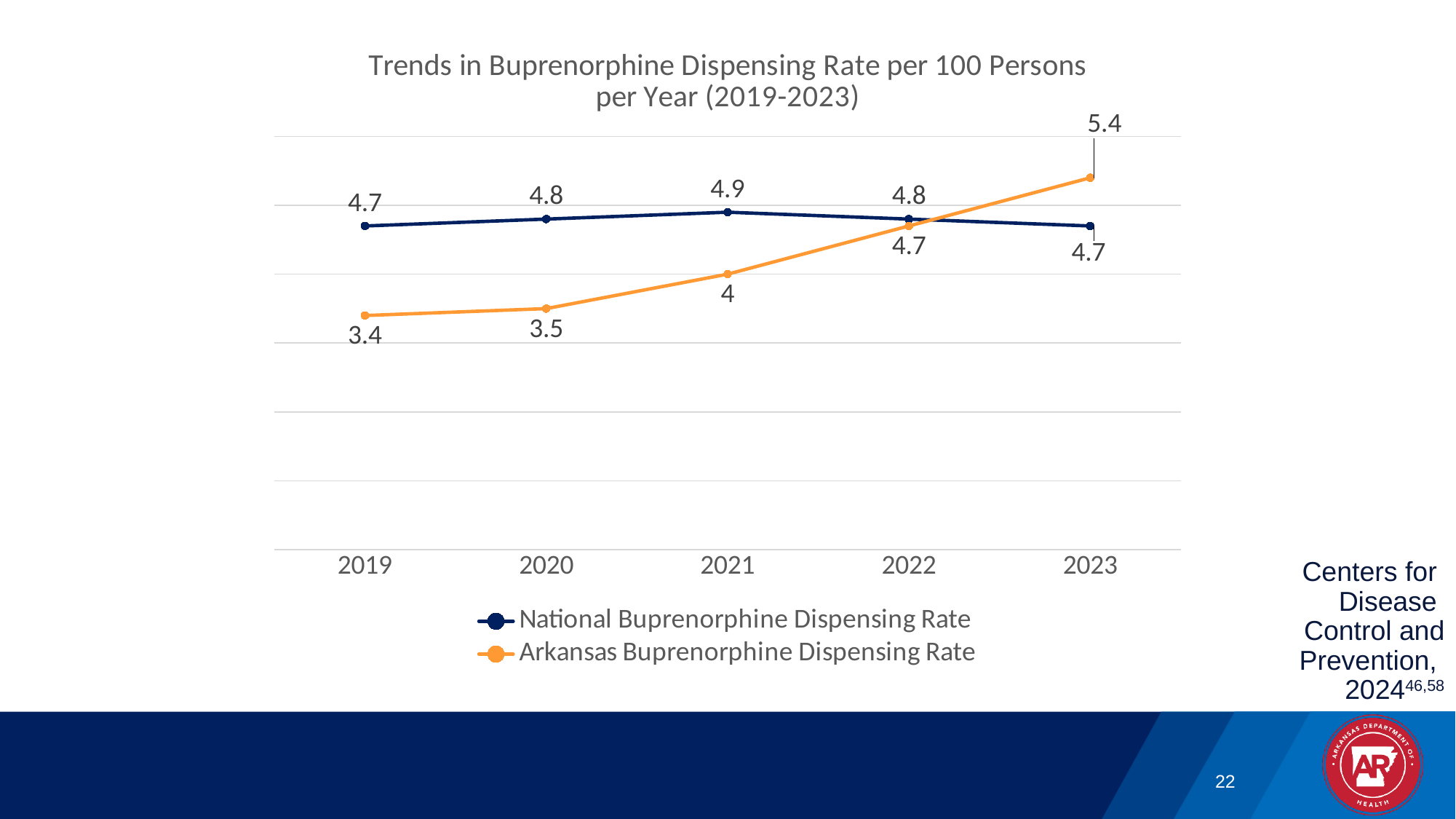
In which year is the Arkansas Buprenorphine Dispensing Rate lowest? 2019 In 2023, which is larger: the National rate or the Arkansas rate? Arkansas Buprenorphine Dispensing Rate How many series does the legend list? 2 What is the Arkansas Buprenorphine Dispensing Rate in 2023? 5.4 How many years are plotted on the x axis? 5 What is the difference between the Arkansas rate in 2023 and the Arkansas rate in 2019? 2 What kind of chart is shown on the slide? Line chart In which year is the Arkansas Buprenorphine Dispensing Rate highest? 2023 In which year is the National Buprenorphine Dispensing Rate highest? 2021 In 2020, which is larger: the National rate or the Arkansas rate? National Buprenorphine Dispensing Rate What is the National Buprenorphine Dispensing Rate in 2021? 4.9 What is the Arkansas Buprenorphine Dispensing Rate in 2019? 3.4